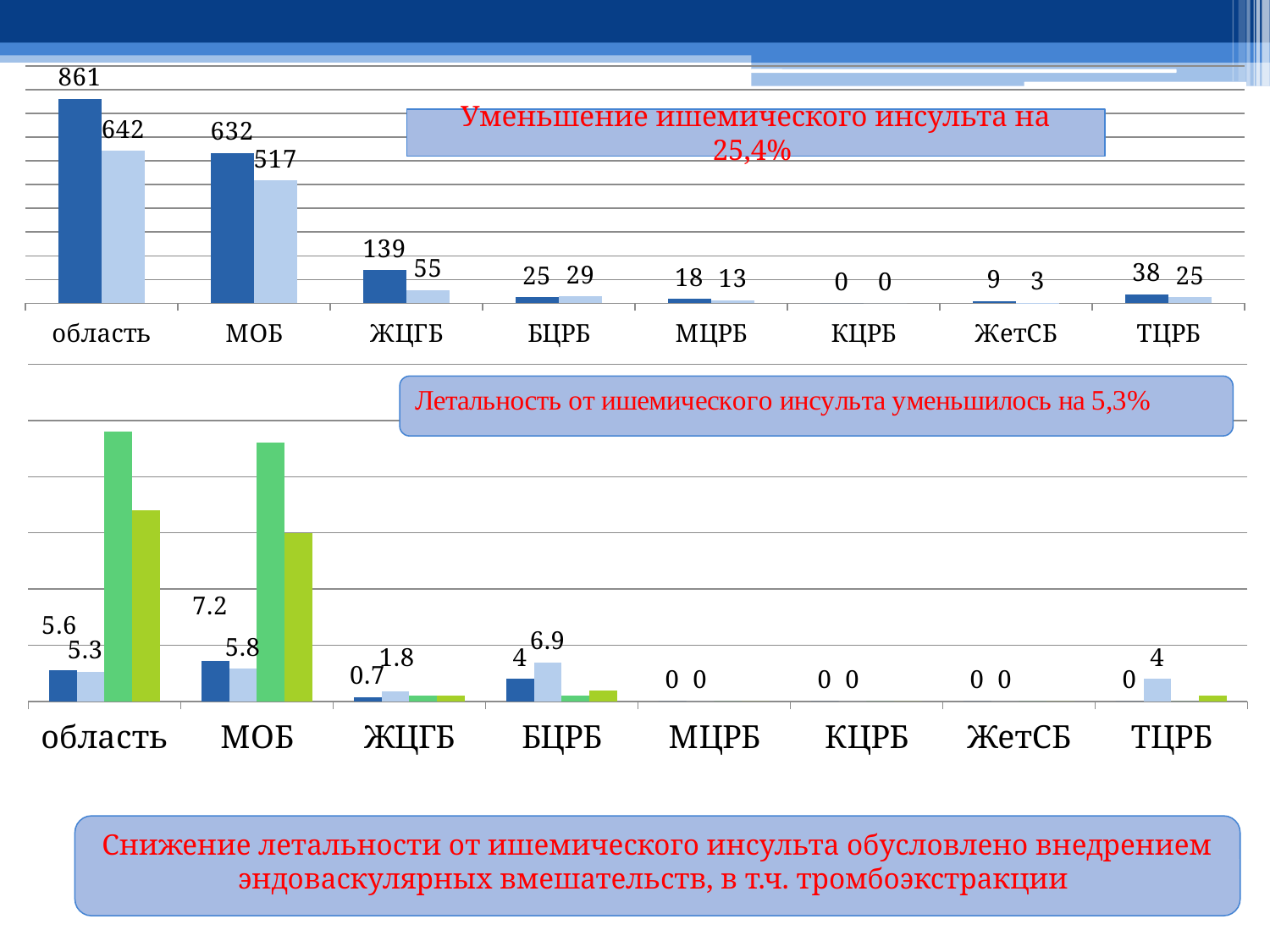
In the top chart, what is the value of the light blue bar for ТЦРБ? 25 In the top chart, for БЦРБ, which is larger: the dark blue bar or the light blue bar? the light blue bar (29) In the bottom chart, what is the value of the dark blue bar for МОБ? 7.2 In the bottom chart, what is the value of the light blue bar for БЦРБ? 6.9 What text is written in the box over the top chart? Уменьшение ишемического инсульта на 25,4% In the top chart, what is the value of the dark blue bar for область? 861 What kind of chart is the top chart? bar chart In the top chart, which category has the highest dark blue bar? область In the top chart, what is the value of the light blue bar for МОБ? 517 In the top chart, what is the difference between the dark blue and light blue values for ЖЦГБ? 84 How many categories are shown on the x axis of the top chart? 8 In the bottom chart, what is the difference between the dark blue and light blue values for область? 0.3